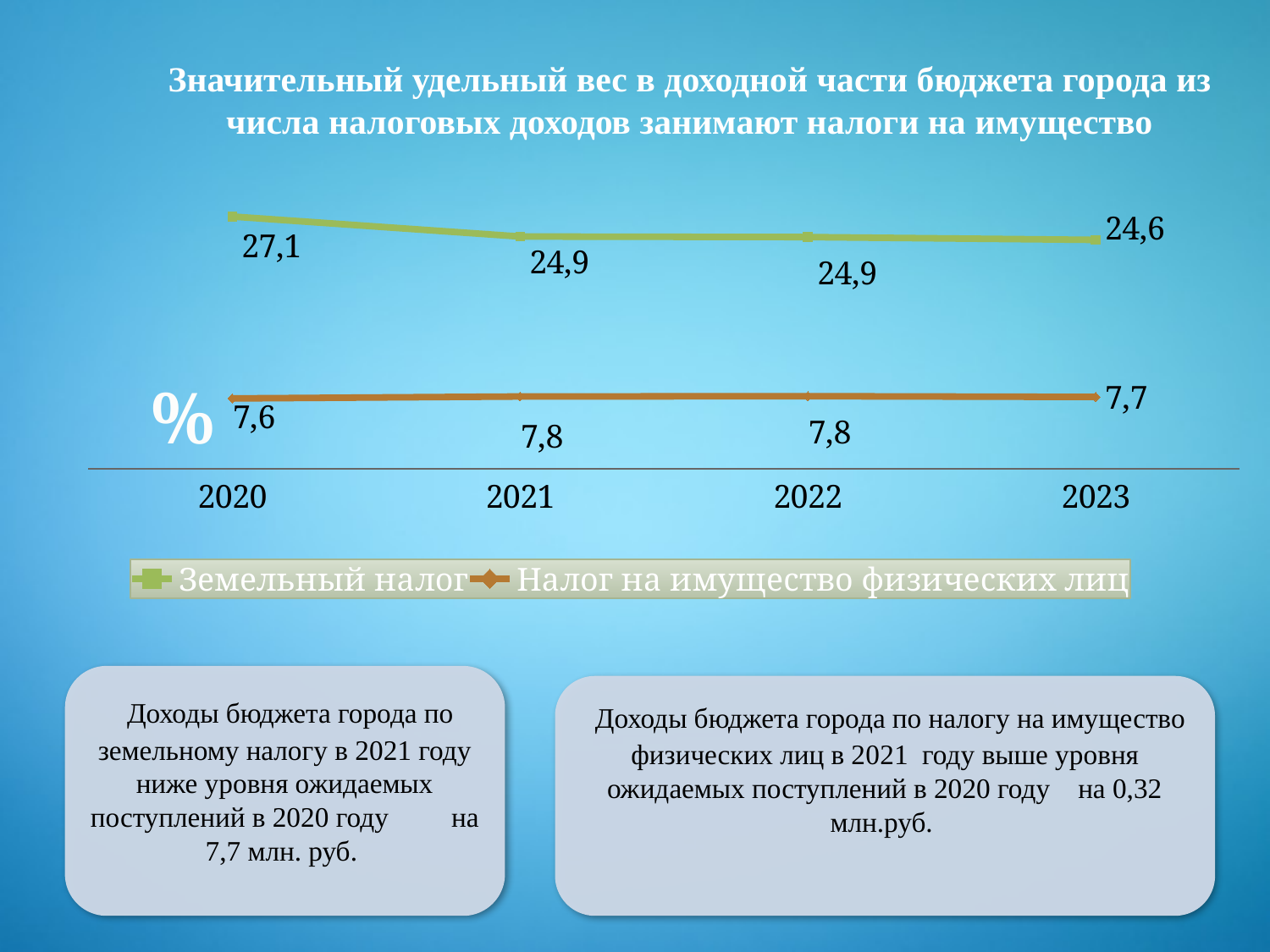
What is the value for Налог на имущество физических лиц in 2023? 7,7 What is the value for Налог на имущество физических лиц in 2021? 7,8 How many series does the legend list? 2 What is the value for Земельный налог in 2020? 27,1 Does the value for Земельный налог rise or fall from 2020 to 2023? fall What is the difference between the Земельный налог values in 2020 and 2023? 2,5 What type of chart is shown on the slide? line chart What is the value for Земельный налог in 2023? 24,6 Which series has the larger value in 2022, Земельный налог or Налог на имущество физических лиц? Земельный налог In which year is the value for Налог на имущество физических лиц lowest? 2020 In which year is the value for Земельный налог highest? 2020 How many years are shown on the x axis? 4